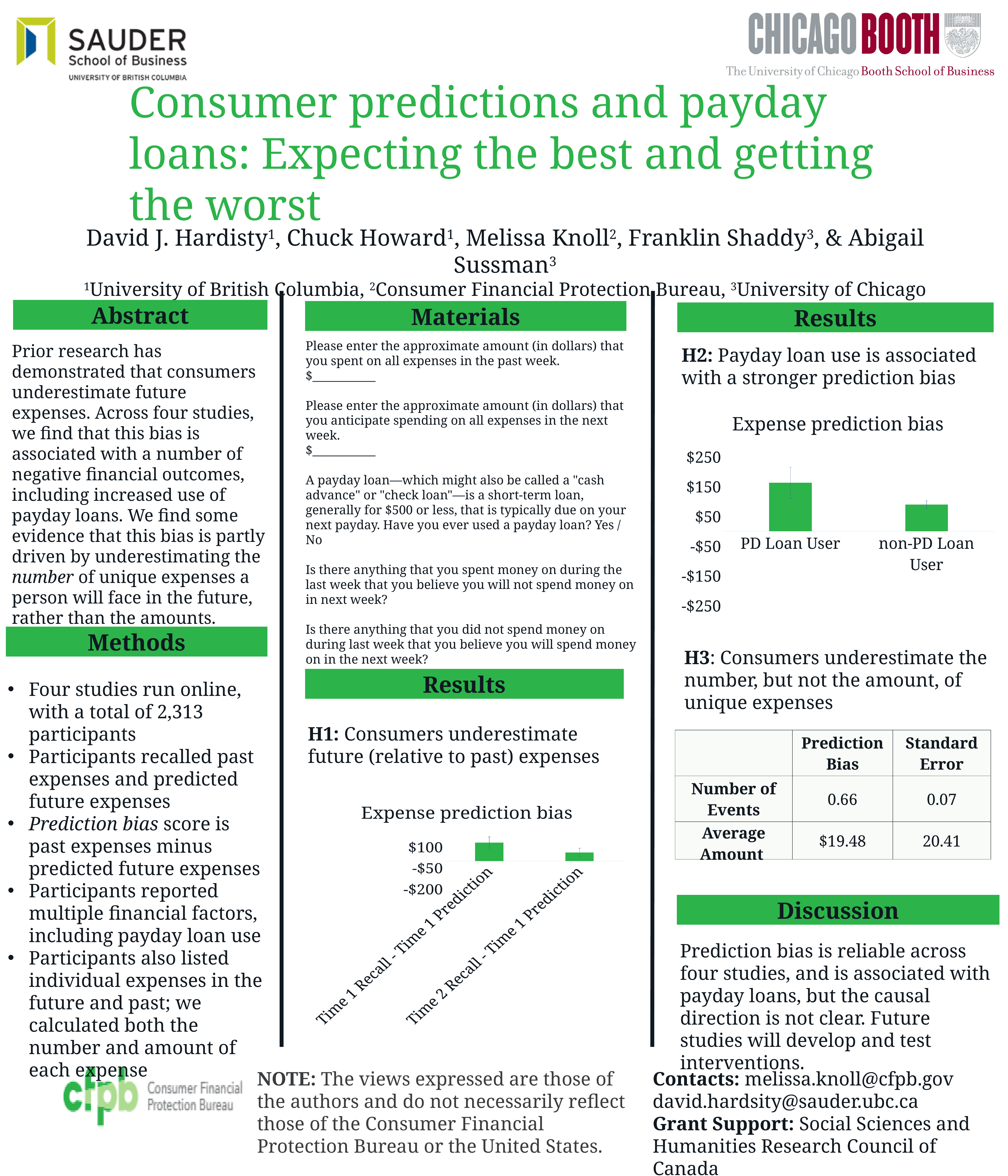
What type of chart is shown under H2 (right column)? bar chart In the chart under H2 (right column), is the value for PD Loan User greater or less than $50? greater In the chart under H1 (middle column), is the value for Time 2 Recall - Time 1 Prediction greater or less than $100? less What is the title of the chart under H2 (right column)? Expense prediction bias In the chart under H2 (right column), which category has the lowest value? non-PD Loan User How many categories are shown in the chart under H2 (right column)? 2 In the chart under H2 (right column), is the value for non-PD Loan User greater or less than $150? less How many bars are shown in the chart under H1 (middle column)? 2 In the chart under H2 (right column), which category has the higher value, PD Loan User or non-PD Loan User? PD Loan User In the chart under H1 (middle column), which category has the higher value? Time 1 Recall - Time 1 Prediction